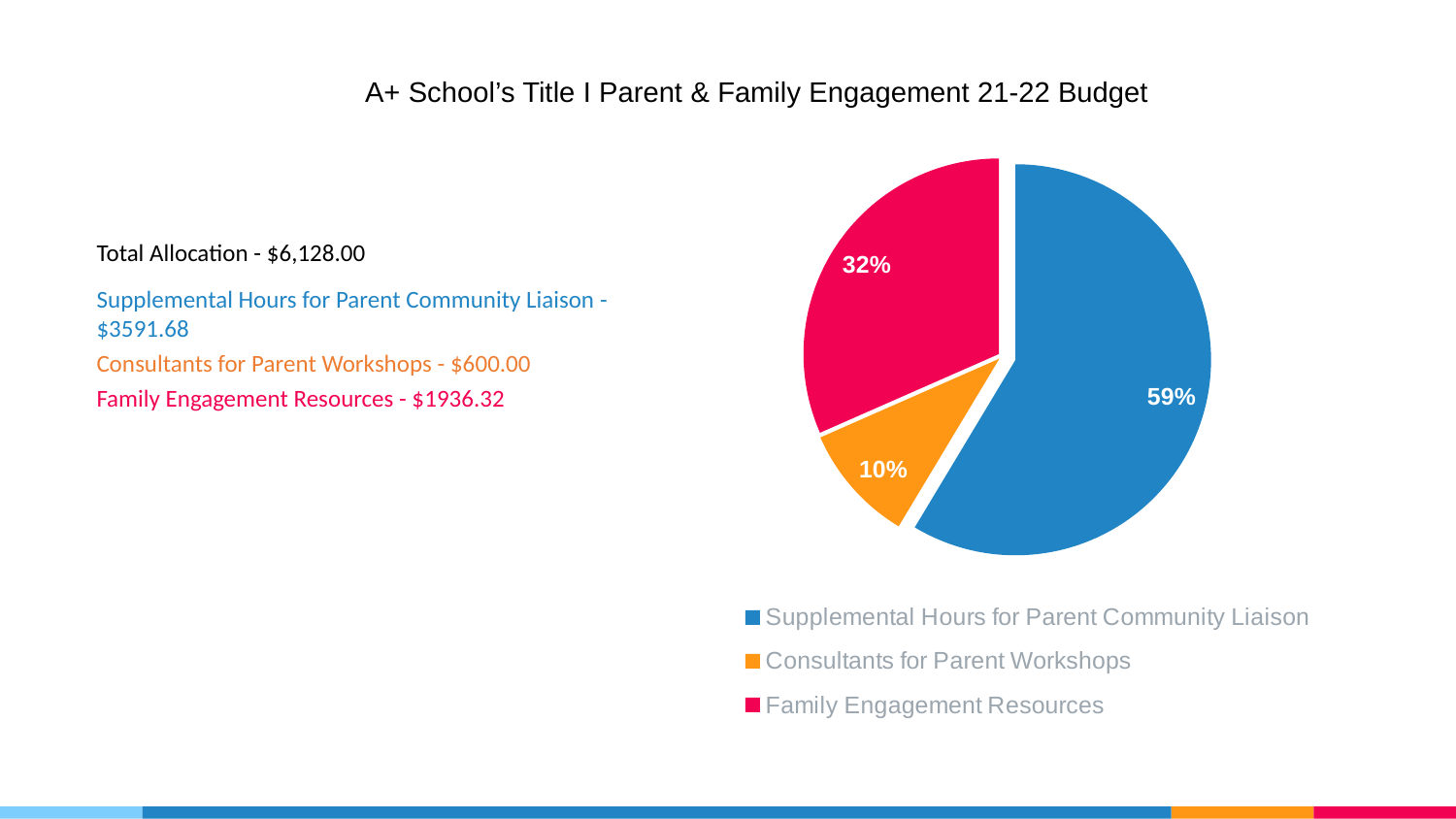
Which category has the smallest slice of the pie? Consultants for Parent Workshops What percentage of the pie is Supplemental Hours for Parent Community Liaison? 59% What is the difference in percentage points between the Supplemental Hours for Parent Community Liaison slice and the Family Engagement Resources slice? 27 What percentage of the pie is Consultants for Parent Workshops? 10% What percentage of the pie is Family Engagement Resources? 32% What kind of chart is shown on the slide? pie chart Which category has the largest slice of the pie? Supplemental Hours for Parent Community Liaison What colour is the Consultants for Parent Workshops slice? orange How many entries does the legend list? 3 Which slice is larger, Family Engagement Resources or Consultants for Parent Workshops? Family Engagement Resources What colour is the Family Engagement Resources slice? red How many slices does the pie chart have? 3